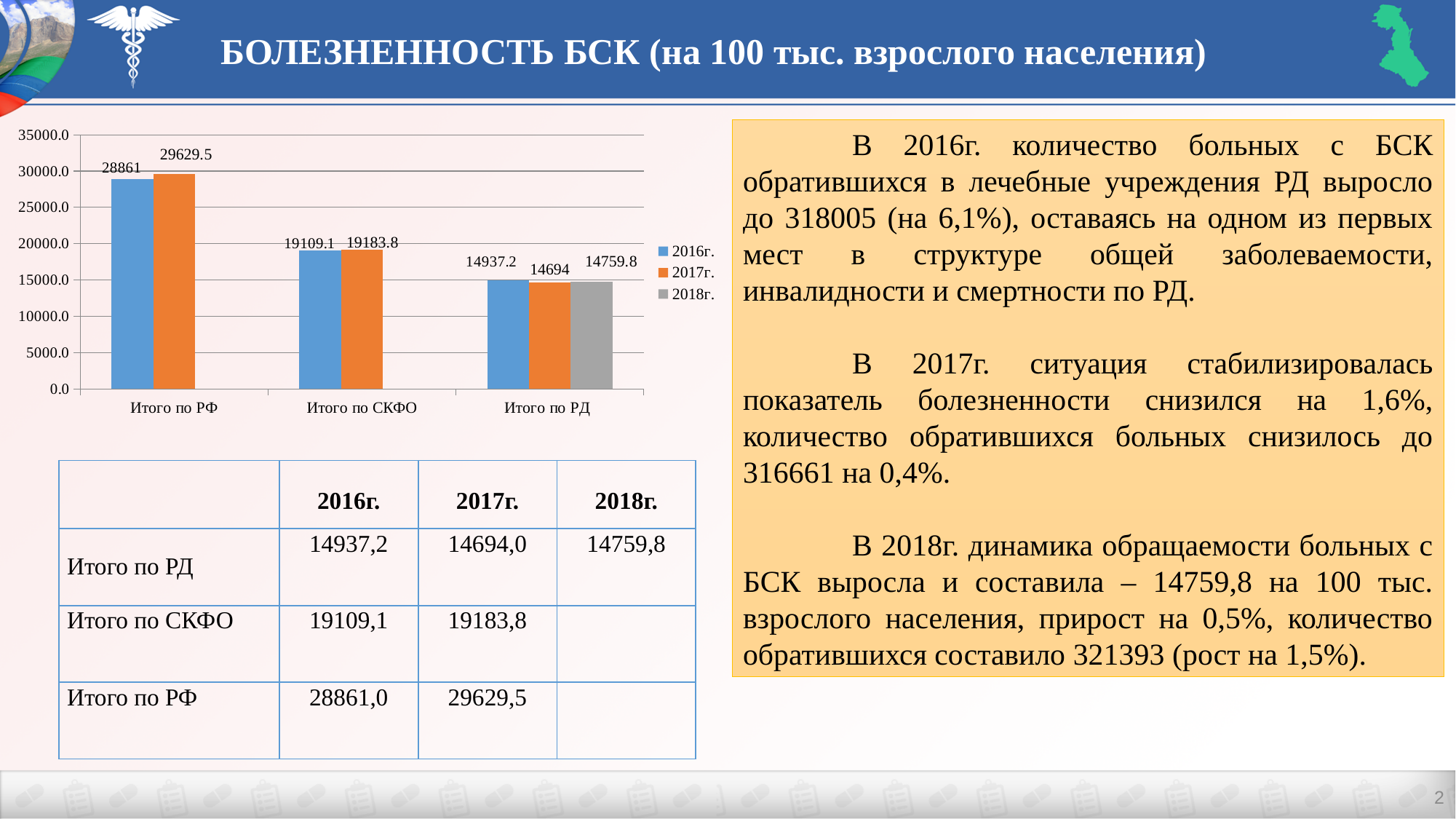
How many series does the chart legend list? 3 What is the difference between the 2017г. and 2016г. values for Итого по РФ? 768.5 Which category has the highest value in the 2016г. series? Итого по РФ What is the value for Итого по СКФО in the 2016г. series? 19109.1 Which is larger for Итого по РД: the 2016г. value or the 2017г. value? 2016г. What is the value for Итого по РФ in the 2017г. series? 29629.5 Is the 2016г. value for Итого по СКФО greater or less than 20000.0? less Which category is the only one with a bar for the 2018г. series? Итого по РД What kind of chart is shown on the slide? bar chart Which category has the lowest value in the 2017г. series? Итого по РД What is the value for Итого по РД in the 2018г. series? 14759.8 How many categories are shown on the x axis of the chart? 3